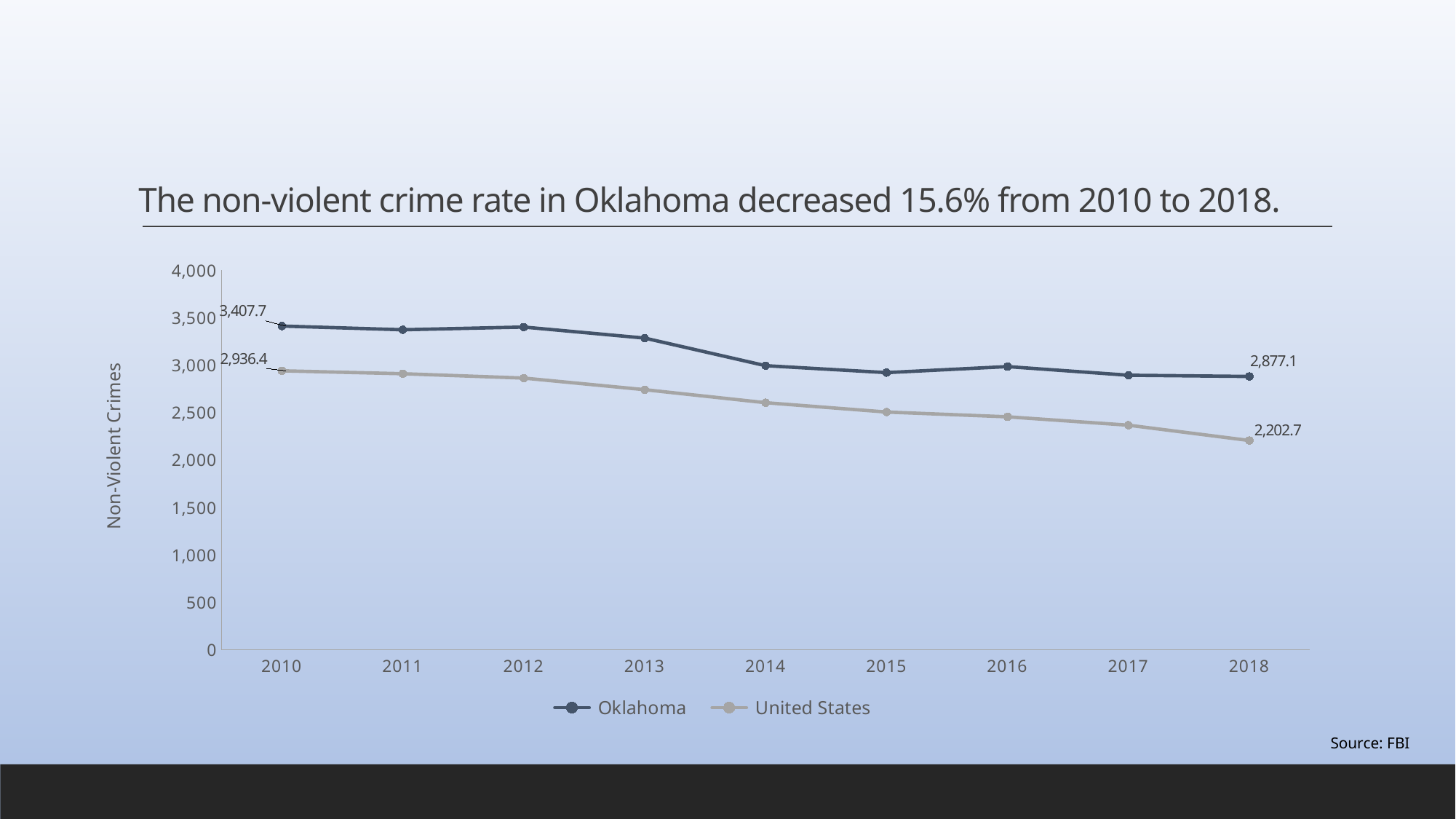
How many years are shown on the x axis? 9 Is the value for the United States in 2017 greater or less than 2,500? less Is the value for Oklahoma in 2013 greater or less than 3,000? greater What is the difference between the Oklahoma and United States values in 2018? 674.4 In which year is the United States value lowest? 2018 By how much did the Oklahoma value fall from 2010 to 2018? 530.6 Which series has the higher value in 2018, Oklahoma or United States? Oklahoma What is the value for Oklahoma in 2010? 3,407.7 How many series does the legend list? 2 What is the value for Oklahoma in 2018? 2,877.1 What is the value for the United States in 2010? 2,936.4 What is the value for the United States in 2018? 2,202.7